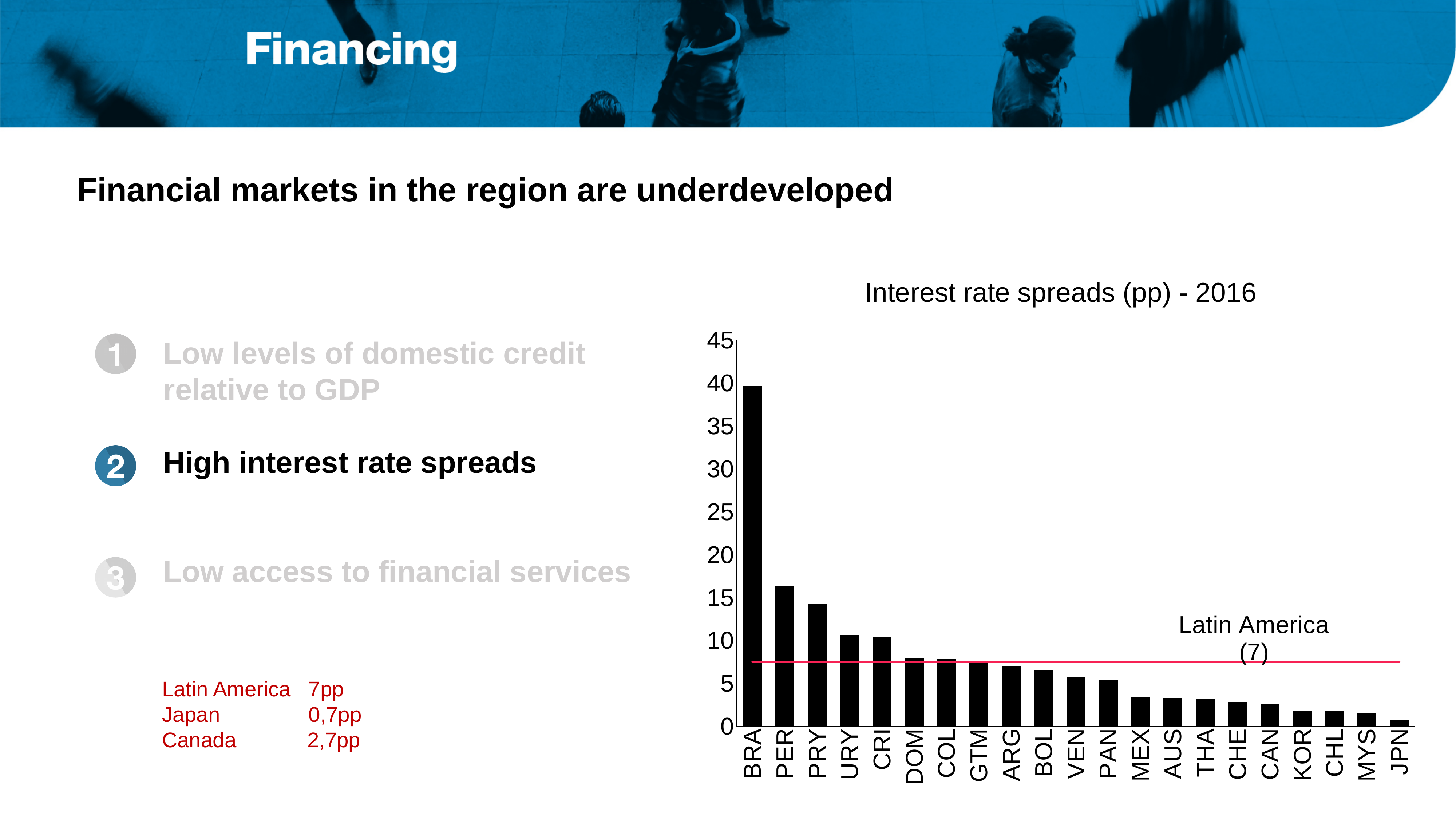
Which has the larger interest rate spread, PER or PRY? PER What value does the red horizontal line labelled Latin America mark? 7 Which country has the lowest interest rate spread in the chart? JPN Which country has the highest interest rate spread in the chart? BRA Is the value for BRA greater or less than 35? greater Is the value for PER greater or less than 15? greater Is the value for MEX greater or less than 5? less What is the title of the chart? Interest rate spreads (pp) - 2016 Do the bar values rise or fall moving from left to right along the x axis? fall What kind of chart is shown on the slide? bar chart How many countries are shown on the x axis of the chart? 21